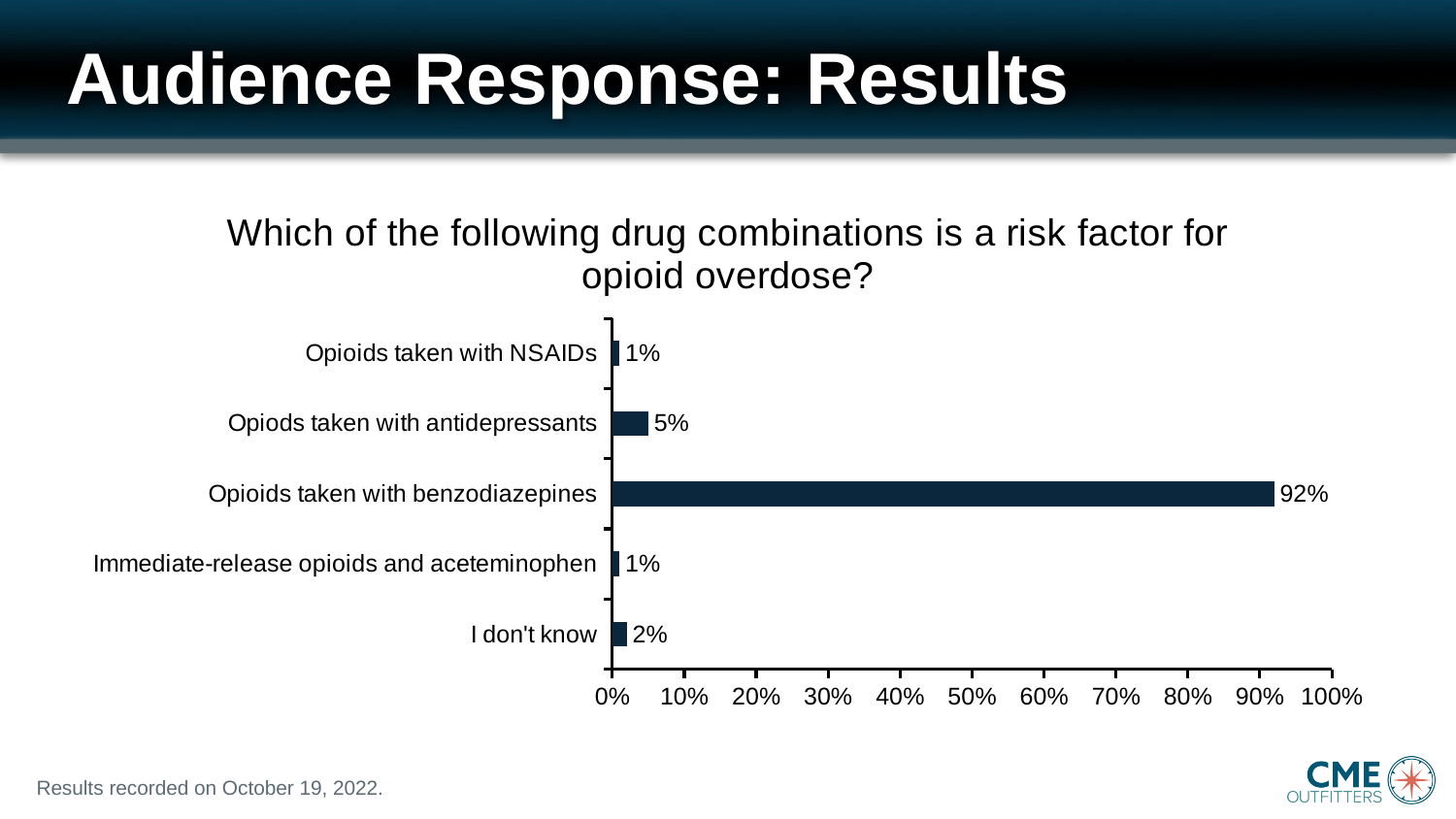
What is the difference in percentage points between "Opioids taken with benzodiazepines" and "Opiods taken with antidepressants"? 87 Which response option received the highest percentage? Opioids taken with benzodiazepines How many response options are shown in the chart? 5 Which received a larger share of responses: "I don't know" or "Opiods taken with antidepressants"? Opiods taken with antidepressants What question does the chart present results for? Which of the following drug combinations is a risk factor for opioid overdose? What percentage of respondents chose "Opioids taken with benzodiazepines"? 92% Is the value for "Opioids taken with benzodiazepines" greater or less than 90%? greater What type of chart is shown on the slide? Bar chart What percentage of respondents chose "Opiods taken with antidepressants"? 5% What percentage of respondents chose "Opioids taken with NSAIDs"? 1% What percentage of respondents answered "I don't know"? 2% What is the maximum value shown on the horizontal axis? 100%